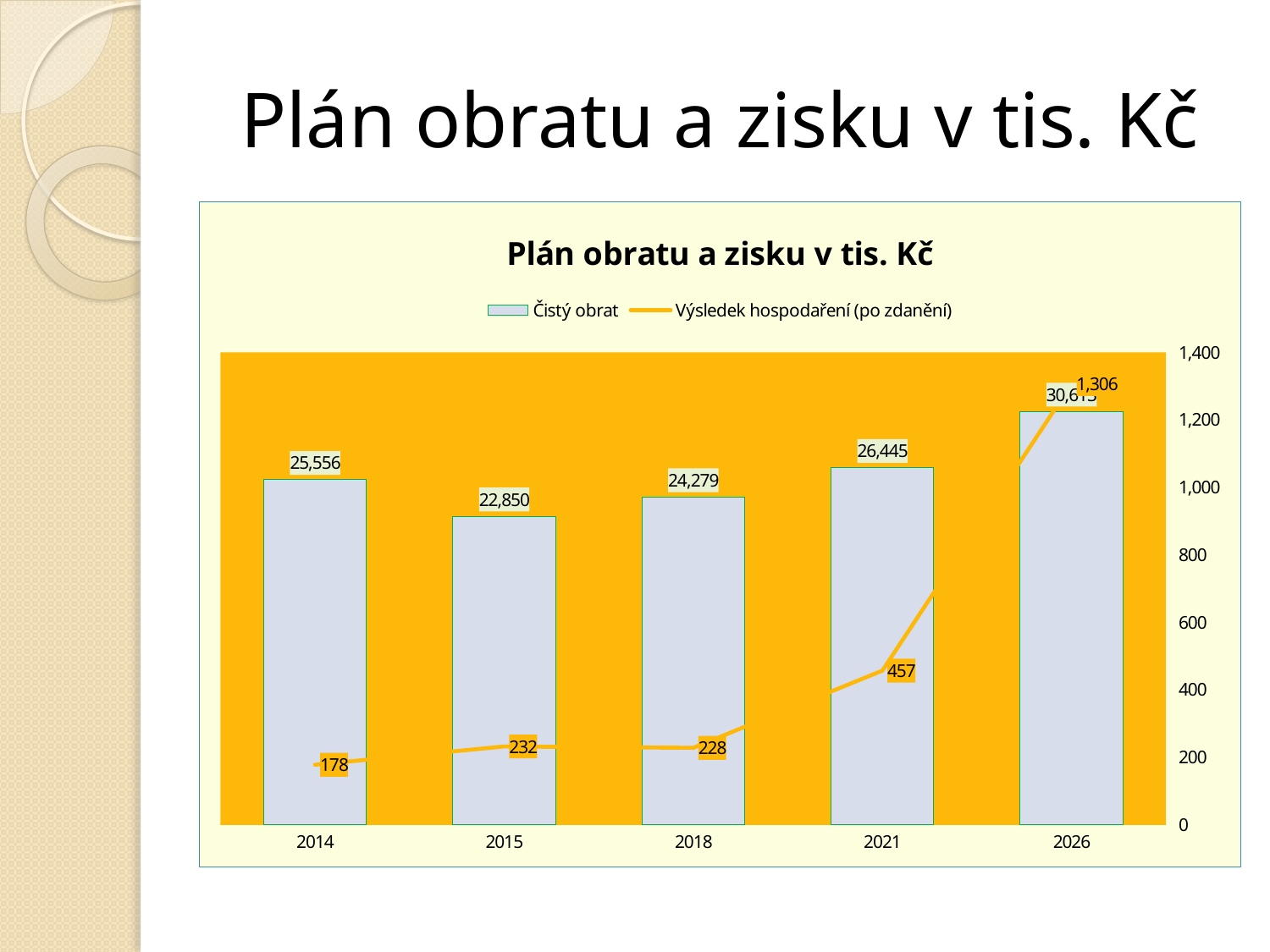
In which year is Čistý obrat the lowest? 2015 Is the value of Výsledek hospodaření (po zdanění) for 2026 greater or less than 1,200? greater What kind of chart is this? Combination bar and line chart What is the difference between Čistý obrat in 2021 and in 2018? 2,166 What is the difference between Výsledek hospodaření (po zdanění) in 2015 and in 2014? 54 What is the value of Výsledek hospodaření (po zdanění) for 2015? 232 Which year has the larger Čistý obrat, 2014 or 2018? 2014 In which year is Výsledek hospodaření (po zdanění) the highest? 2026 How many years are shown on the x axis? 5 How many series does the legend list? 2 What is the value of Čistý obrat for 2014? 25,556 What is the value of Výsledek hospodaření (po zdanění) for 2021? 457